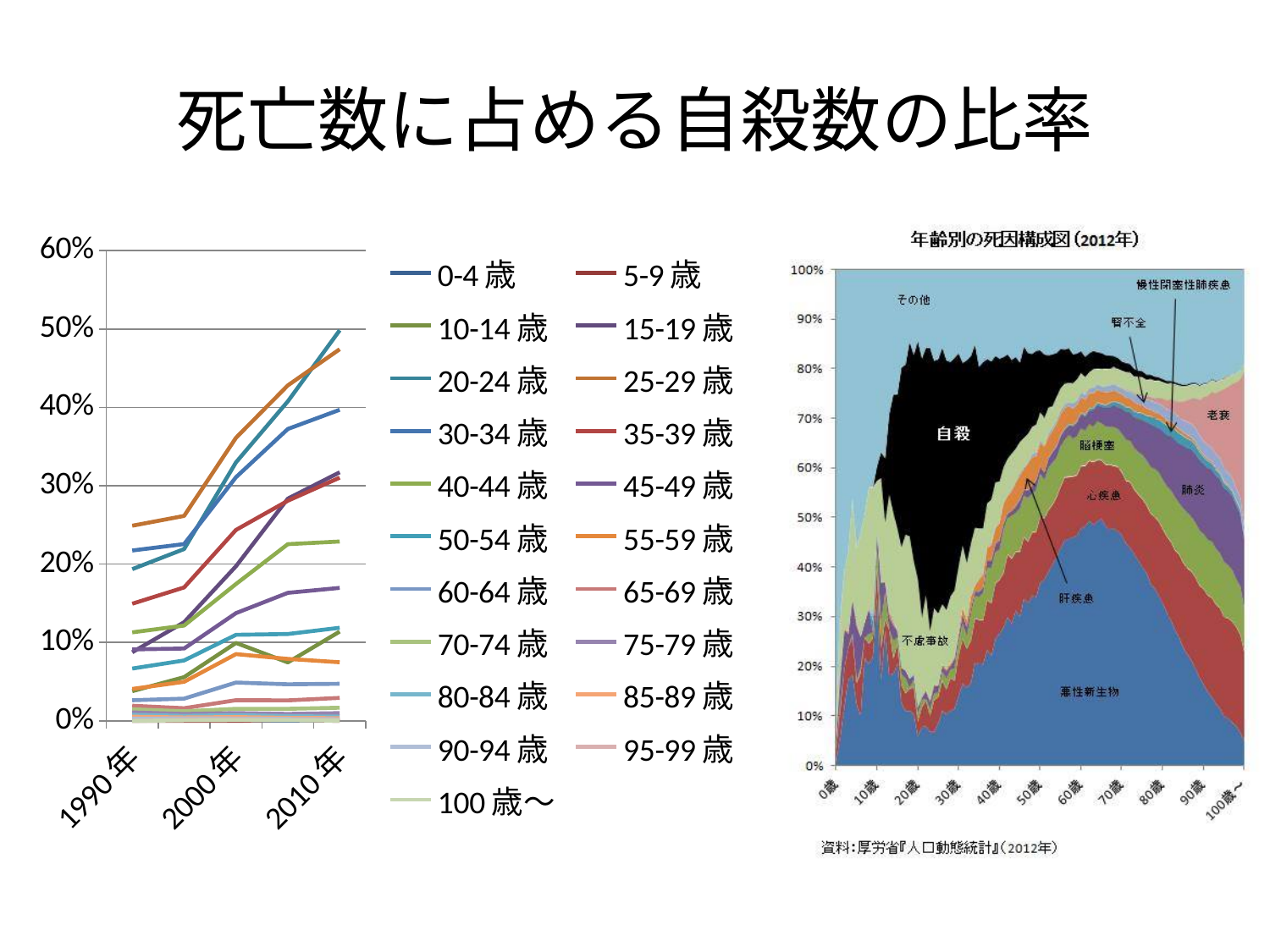
What is the first year shown on the x axis of the left chart? 1990年 In the left chart, does the value for 25-29歳 rise or fall from 1990年 to 2010年? rise How many years are shown on the x axis of the left chart? 3 In the left chart, which is larger in 2010年: the value for 20-24歳 or the value for 45-49歳? 20-24歳 How many series does the legend of the left chart list? 21 In the left chart, is the value for 45-49歳 in 2010年 greater or less than 20%? less What is the title of the chart on the right side of the slide? 年齢別の死因構成図（2012年） In the left chart, is the value for 15-19歳 in 1990年 greater or less than 10%? less In the left chart, is the value for 25-29歳 in 2010年 greater or less than 40%? greater What kind of chart is the chart on the left side of the slide? line chart What is the highest value shown on the y axis of the right chart? 100%